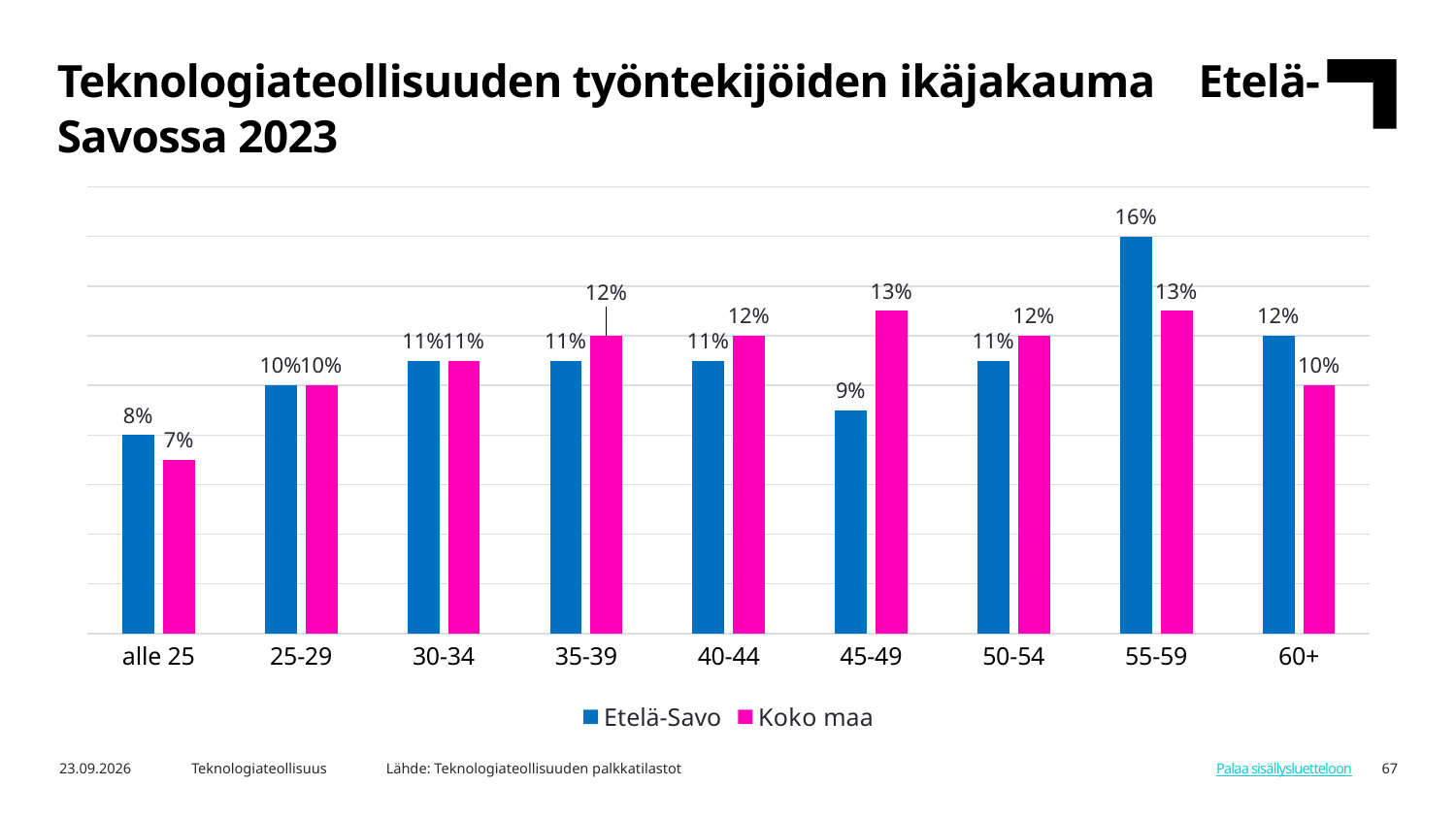
What is the difference between Etelä-Savo and Koko maa in the 45-49 age group? 4% What is the value for Etelä-Savo in the alle 25 age group? 8% What type of chart is shown on the slide? bar chart Which series is shown in pink in the legend? Koko maa In the 60+ age group, which series has the larger value, Etelä-Savo or Koko maa? Etelä-Savo How many age categories are shown on the x axis? 9 Which age group has the highest value for Etelä-Savo? 55-59 What is the difference between the Etelä-Savo values for 55-59 and 45-49? 7% What is the value for Koko maa in the 45-49 age group? 13% Which age group has the lowest value for Koko maa? alle 25 How many series does the legend list? 2 What is the value for Etelä-Savo in the 55-59 age group? 16%